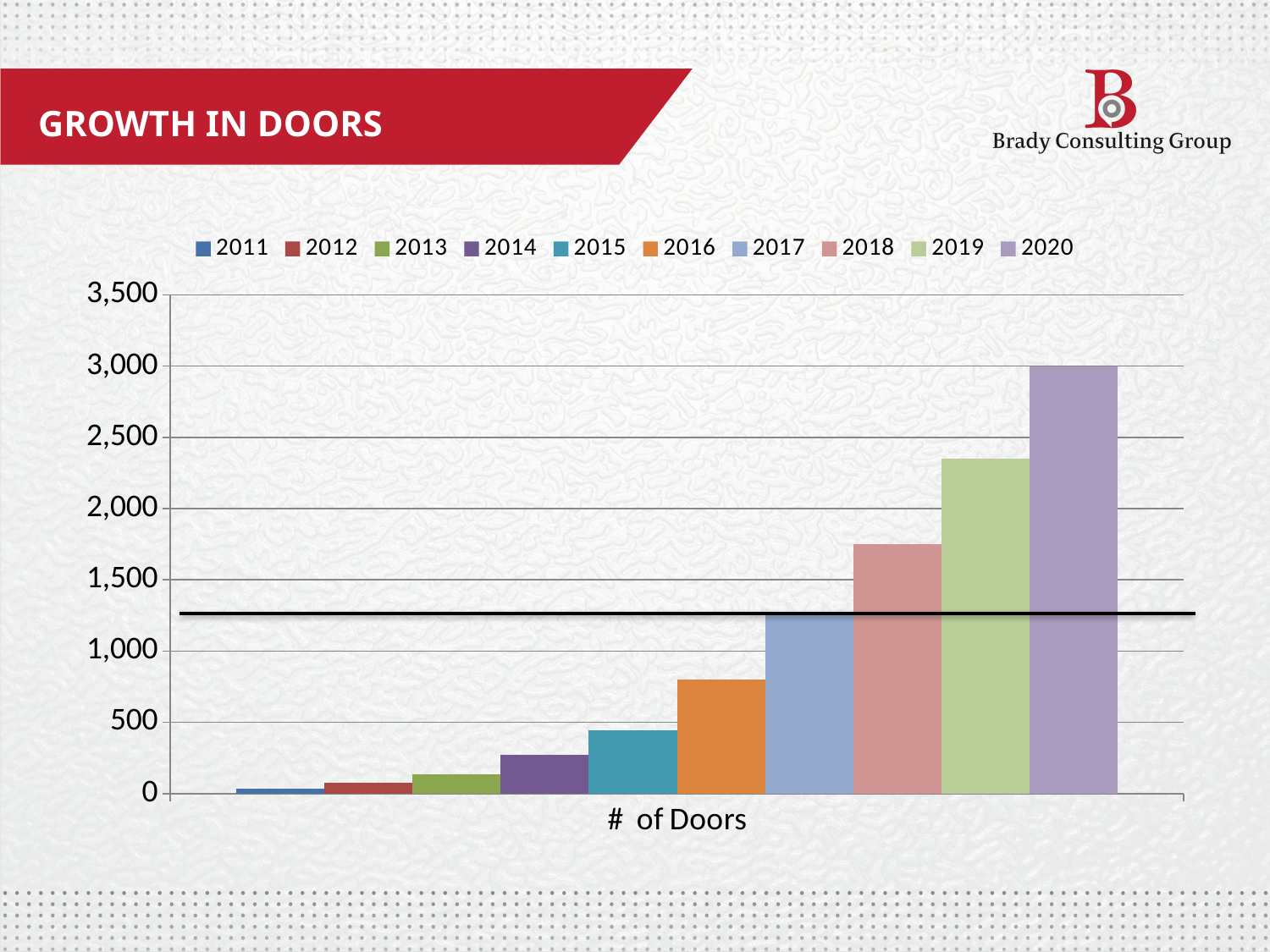
Is the value for 2016 greater or less than 1,000? less Which year has the highest number of doors? 2020 How many series does the legend list? 10 What is the title of the slide containing the chart? GROWTH IN DOORS Is the value for 2019 greater or less than 2,000? greater What is the value for 2020? 3,000 What kind of chart is shown on the slide? bar chart What label appears below the x axis of the chart? # of Doors Which is larger, the value for 2017 or the value for 2015? 2017 Do the values rise or fall from 2011 to 2020? rise Which year has the lowest number of doors? 2011 Is the value for 2018 greater or less than 2,000? less